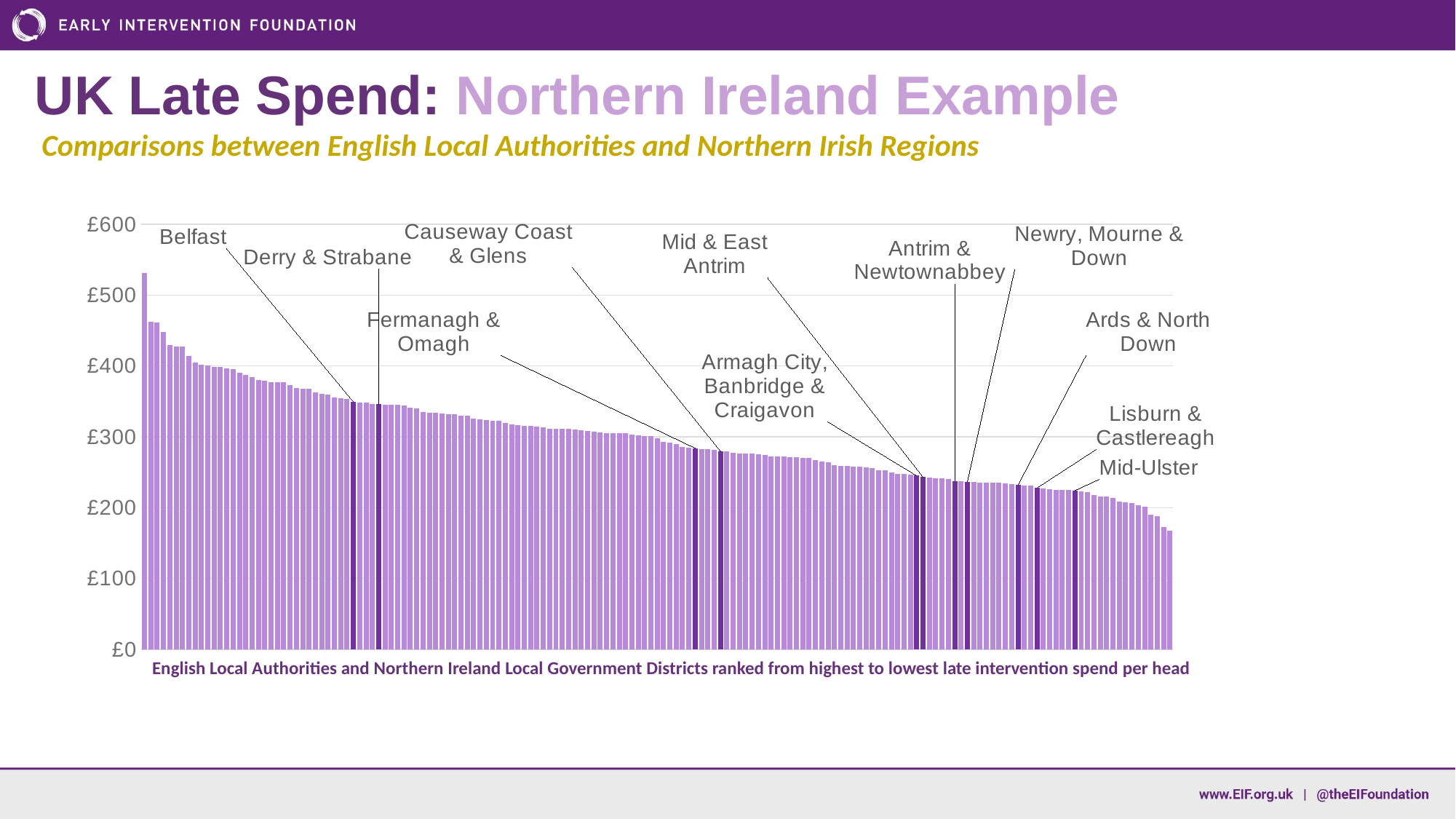
Is the value for Fermanagh & Omagh greater or less than £300? less Which has the larger late intervention spend per head, Derry & Strabane or Causeway Coast & Glens? Derry & Strabane Do the bar values rise or fall from left to right along the x axis? fall What kind of chart is shown on the slide? bar chart Is the value for Belfast greater or less than £300? greater Is the value for Belfast greater or less than £400? less Which labelled Northern Ireland district has the highest late intervention spend per head? Belfast Which labelled Northern Ireland district has the lowest late intervention spend per head? Mid-Ulster Which has the larger late intervention spend per head, Belfast or Mid-Ulster? Belfast How many Northern Ireland districts are labelled on the chart? 11 What is the highest value shown on the y axis? £600